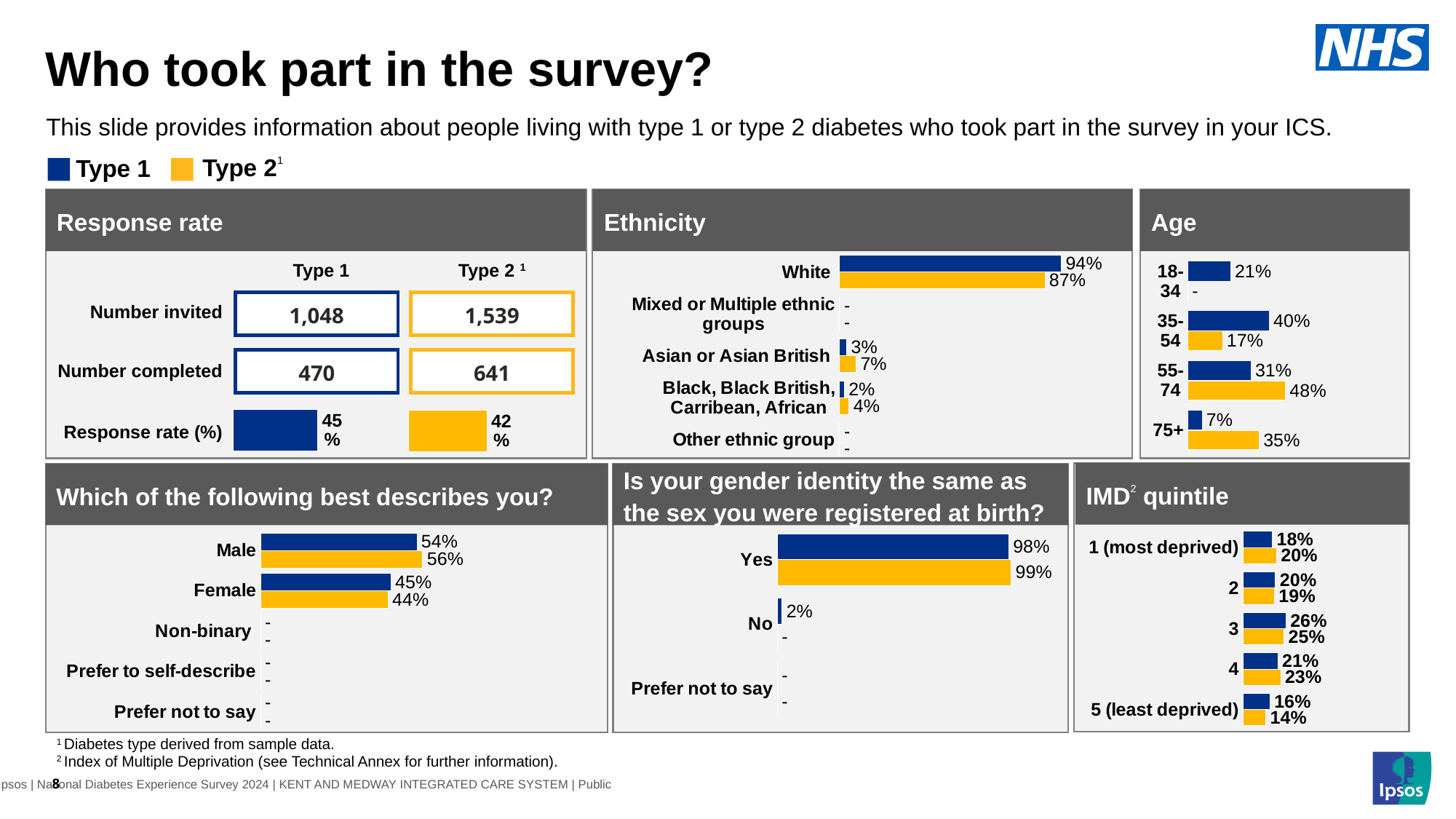
In the Ethnicity chart, what is the difference between the Type 1 and Type 2 values for White? 7% How many series does the legend at the top of the slide list? 2 In the IMD quintile chart, which quintile has the lowest value for Type 2? 5 (least deprived) In the 'Which of the following best describes you?' chart, which is larger for Male: Type 1 or Type 2? Type 2 In the Response rate chart, what is the difference between the number invited for Type 2 and Type 1? 491 In the Ethnicity chart, what percentage of Type 1 respondents are White? 94% In the gender identity chart, what percentage of Type 2 respondents answered Yes? 99% In the Age chart, what percentage of Type 2 respondents are aged 55-74? 48% In the Response rate chart, what is the number completed for Type 2? 641 What kind of chart is the IMD quintile chart? Bar chart How many age groups are shown in the Age chart? 4 In the Age chart, which age group has the highest value for Type 1? 35-54